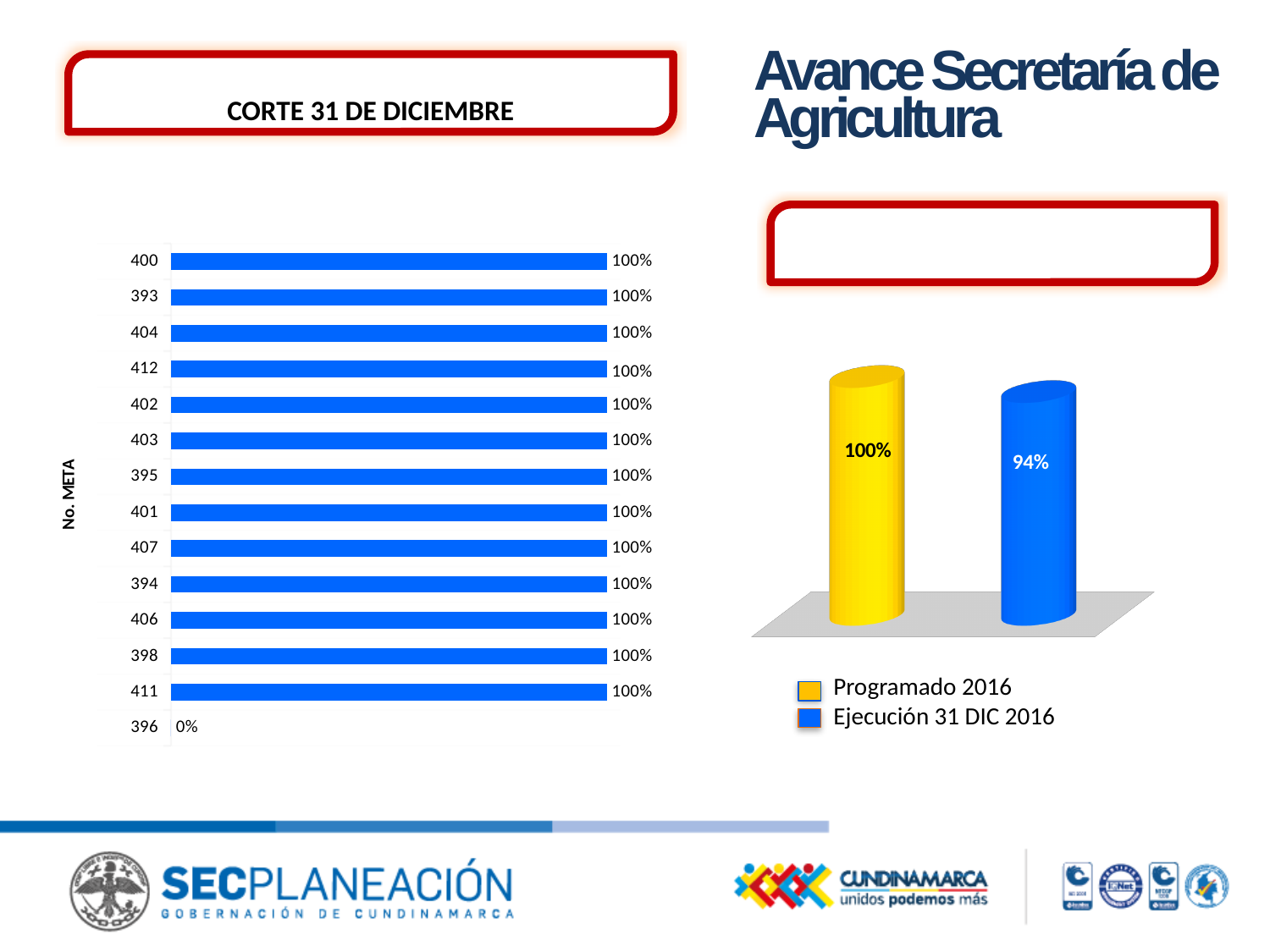
In the right chart, what is the value for Programado 2016? 100% How many metas are listed in the left bar chart? 14 In the right chart, what is the difference between Programado 2016 and Ejecución 31 DIC 2016? 6% In the left bar chart, which meta has the lowest value? 396 In the left bar chart, what is the difference between the values for meta 400 and meta 396? 100% In the right chart, what colour is the Ejecución 31 DIC 2016 bar? blue What kind of chart is the left chart? bar chart How many series does the legend of the right chart list? 2 In the right chart, which is larger, Programado 2016 or Ejecución 31 DIC 2016? Programado 2016 In the left bar chart, what is the value for meta 412? 100% In the right chart, what is the value for Ejecución 31 DIC 2016? 94% In the left bar chart, what is the value for meta 396? 0%